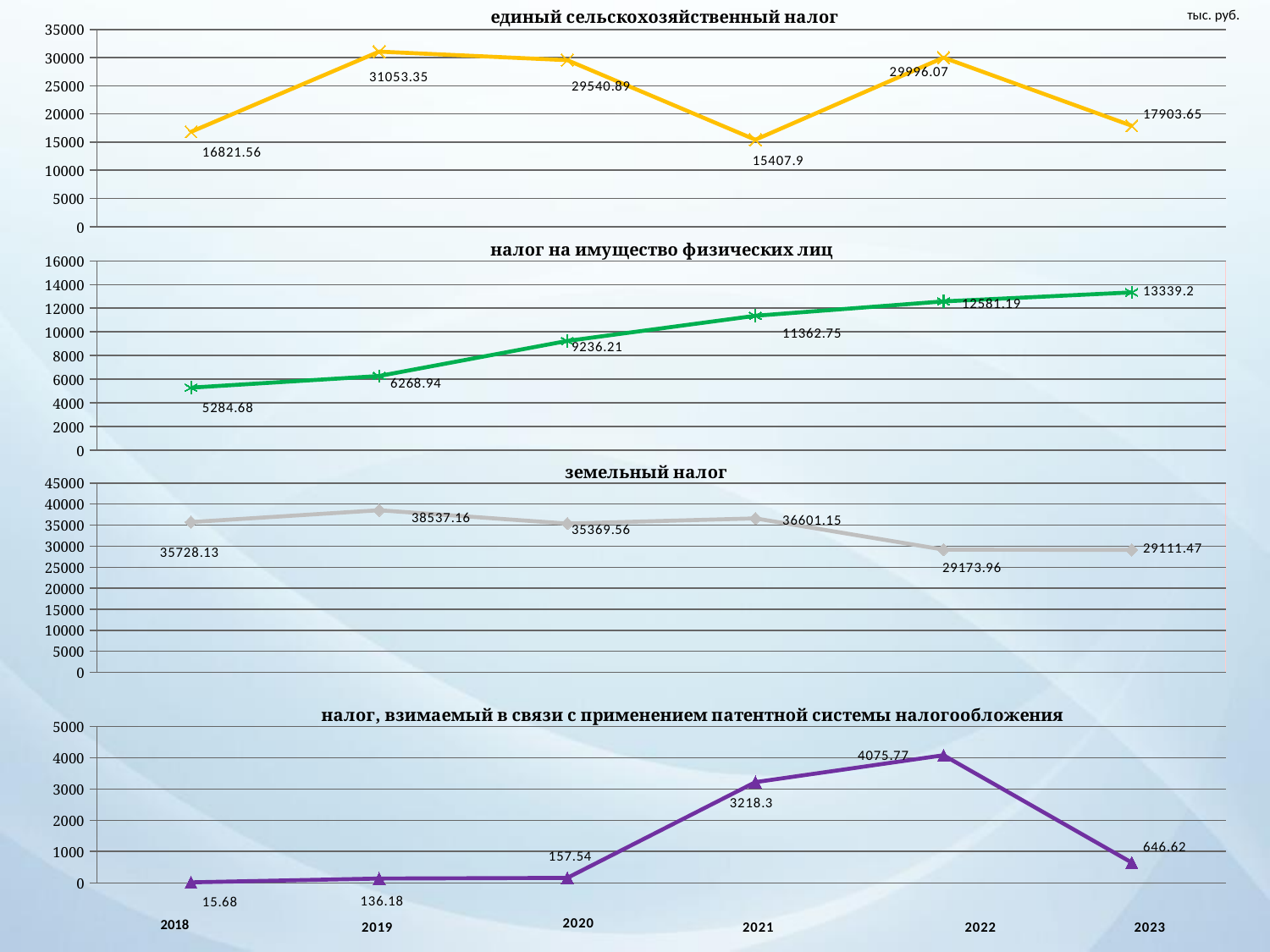
In the chart titled "налог на имущество физических лиц", what is the difference between the 2023 value and the 2018 value? 8054.52 In the chart titled "налог, взимаемый в связи с применением патентной системы налогообложения", what is the value for 2022? 4075.77 In the chart titled "единый сельскохозяйственный налог", what is the value for 2019? 31053.35 In the chart titled "налог на имущество физических лиц", what is the value for 2023? 13339.2 How many data points are plotted in the chart titled "единый сельскохозяйственный налог"? 6 In the chart titled "налог на имущество физических лиц", do the values rise or fall from 2018 to 2023? rise In the chart titled "единый сельскохозяйственный налог", which year has the lowest value? 2021 In the chart titled "налог, взимаемый в связи с применением патентной системы налогообложения", which is larger, the value for 2021 or the value for 2023? 2021 In the chart titled "земельный налог", is the value for 2020 greater or less than 30000? greater What kind of chart is the chart titled "земельный налог"? line chart In the chart titled "земельный налог", what is the value for 2022? 29173.96 In the chart titled "земельный налог", which year has the highest value? 2019